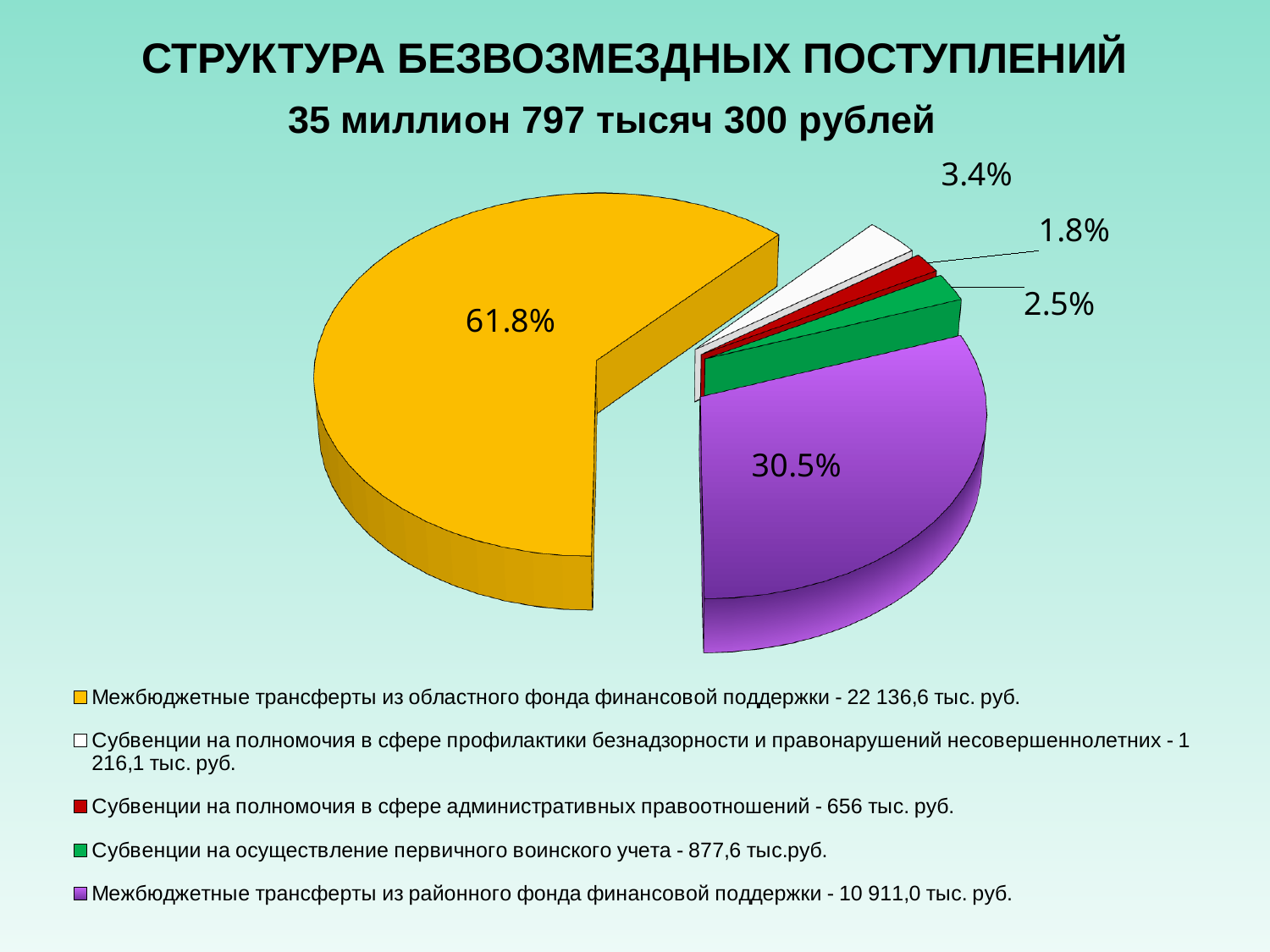
What share of the pie is the slice for 'Межбюджетные трансферты из районного фонда финансовой поддержки'? 30.5% Which category has the largest slice of the pie? Межбюджетные трансферты из областного фонда финансовой поддержки Which category has the smallest slice of the pie? Субвенции на полномочия в сфере административных правоотношений What total amount is stated in the chart's subtitle? 35 миллион 797 тысяч 300 рублей How many entries does the legend list? 5 What share of the pie is the slice for 'Субвенции на полномочия в сфере административных правоотношений'? 1.8% What share of the pie is the slice for 'Межбюджетные трансферты из областного фонда финансовой поддержки'? 61.8% Which is larger: the share for 'Субвенции на осуществление первичного воинского учета' or the share for 'Субвенции на полномочия в сфере административных правоотношений'? Субвенции на осуществление первичного воинского учета How many slices does the pie chart have? 5 What kind of chart is shown on the slide? pie chart What is the difference in percentage points between the yellow slice (61.8%) and the purple slice (30.5%)? 31.3